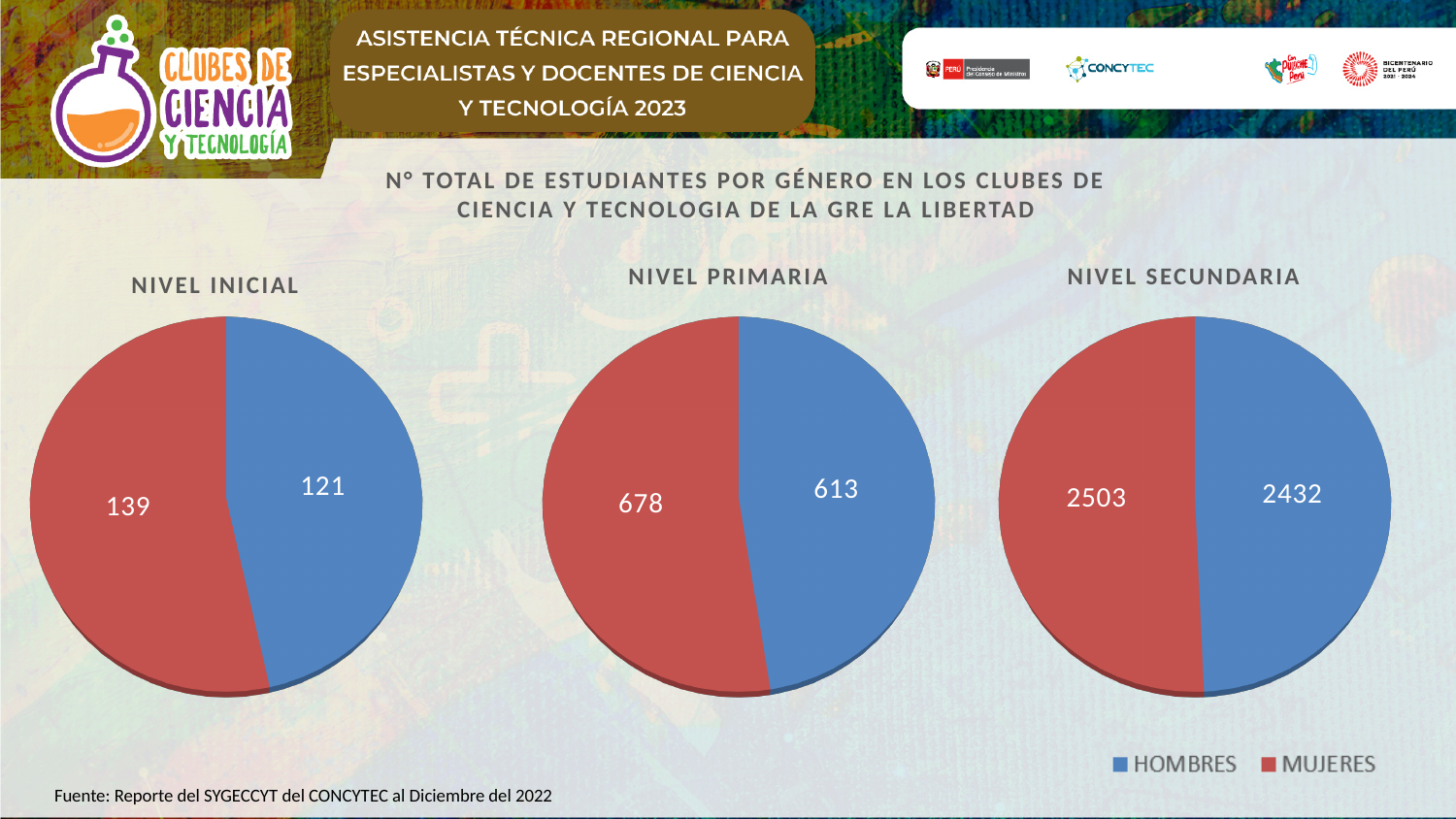
In the Nivel Inicial chart, what is the value for Hombres? 121 In the Nivel Inicial chart, what is the difference between Mujeres and Hombres? 18 In the Nivel Secundaria chart, what is the value for Mujeres? 2503 What kind of chart is used for Nivel Inicial? Pie chart How many series does the legend list? 2 In the Nivel Secundaria chart, what is the total of Hombres and Mujeres? 4935 In the Nivel Secundaria chart, what is the value for Hombres? 2432 In the Nivel Primaria chart, which slice is larger, Hombres or Mujeres? Mujeres In the Nivel Primaria chart, what is the value for Mujeres? 678 In the Nivel Inicial chart, what is the value for Mujeres? 139 Which colour represents Hombres in the charts? Blue In the Nivel Primaria chart, what is the difference between Mujeres and Hombres? 65